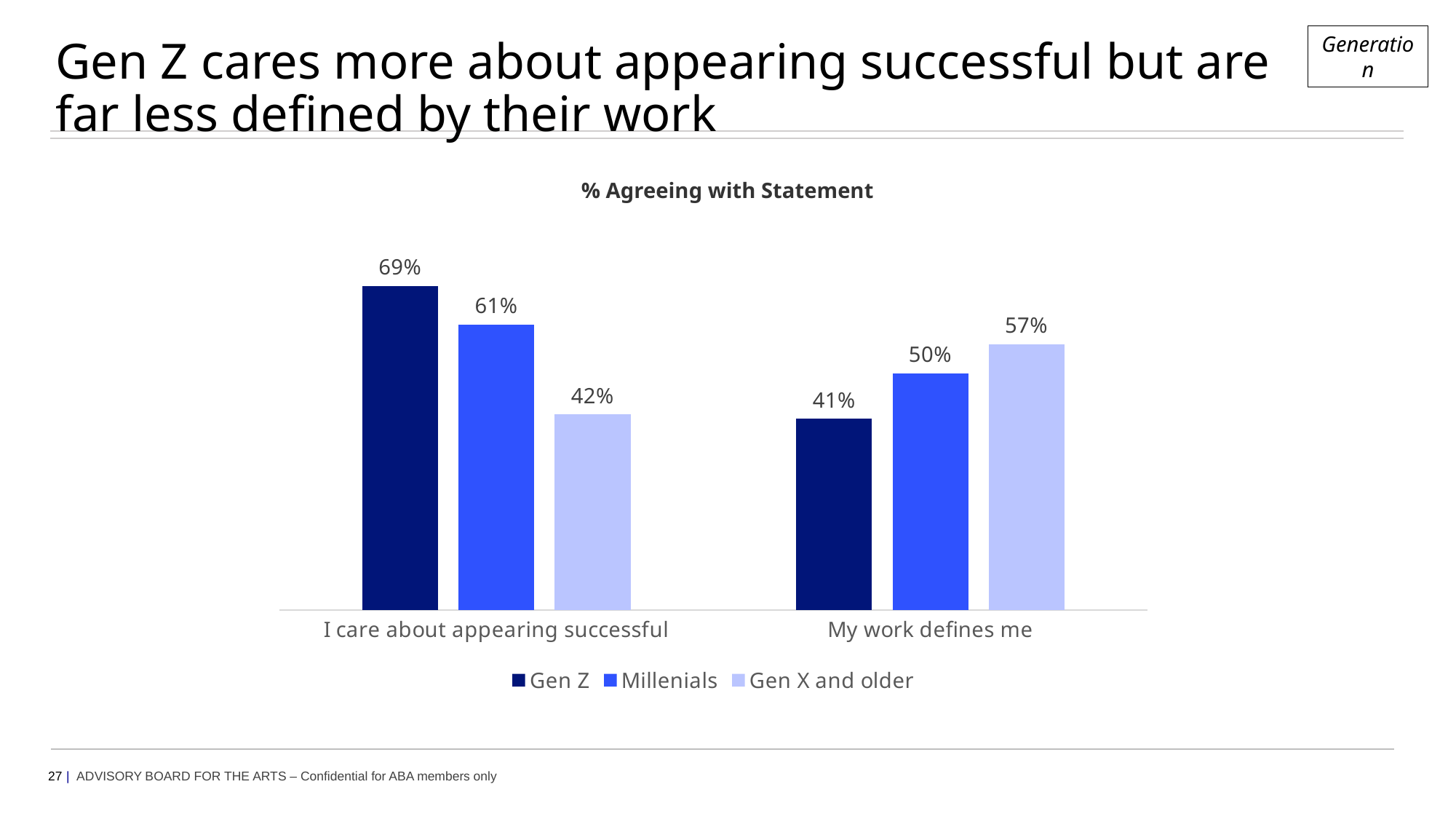
What percentage of Gen X and older agree with the statement "My work defines me"? 57% What is the title of the chart? % Agreeing with Statement What percentage of Millenials agree with the statement "My work defines me"? 50% What is the difference between the Gen X and older and Gen Z values for "My work defines me"? 16% How many statements (categories) are shown on the x axis? 2 How many series does the legend list? 3 Which generation has the highest share agreeing with "I care about appearing successful"? Gen Z Which is larger: the Millenials value for "I care about appearing successful" or the Millenials value for "My work defines me"? I care about appearing successful Which generation has the lowest share agreeing with "My work defines me"? Gen Z What percentage of Gen Z agree with the statement "I care about appearing successful"? 69% What kind of chart is shown on the slide? Bar chart What is the difference between the Gen Z and Gen X and older values for "I care about appearing successful"? 27%